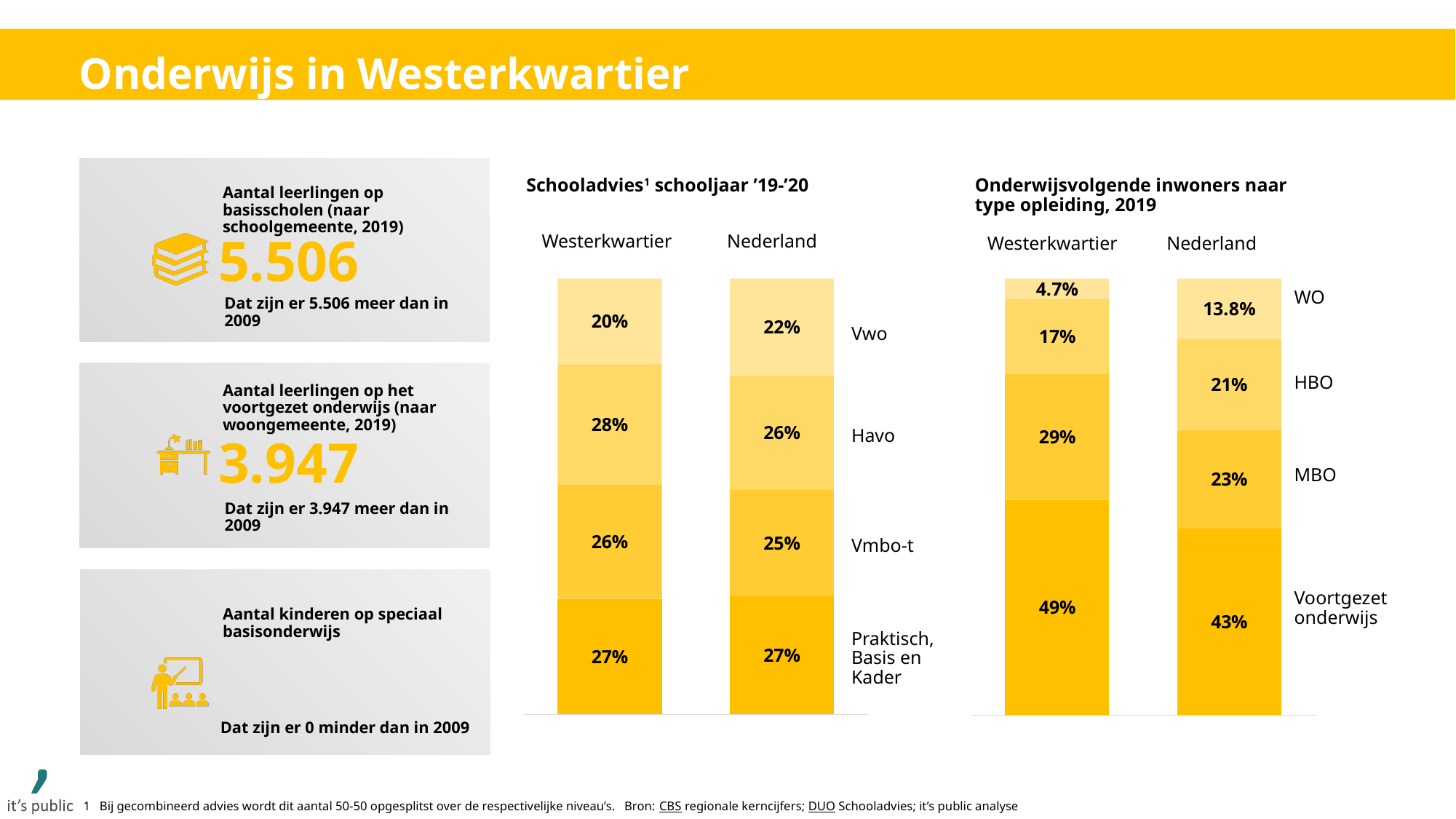
In the chart 'Onderwijsvolgende inwoners naar type opleiding, 2019', what is the difference between the Voortgezet onderwijs shares of Westerkwartier and Nederland? 6% In the chart 'Schooladvies schooljaar '19-'20', which segment is the largest in the Westerkwartier bar? Havo In the chart 'Onderwijsvolgende inwoners naar type opleiding, 2019', which segment is the smallest in the Nederland bar? WO How many bars does the chart 'Onderwijsvolgende inwoners naar type opleiding, 2019' show? 2 In the chart 'Onderwijsvolgende inwoners naar type opleiding, 2019', what is the WO share for Westerkwartier? 4.7% What kind of chart is 'Schooladvies schooljaar '19-'20'? Stacked bar chart In the chart 'Onderwijsvolgende inwoners naar type opleiding, 2019', what is the MBO share for Nederland? 23% In the chart 'Schooladvies schooljaar '19-'20', which is larger: the Vmbo-t share for Westerkwartier or for Nederland? Westerkwartier In the chart 'Schooladvies schooljaar '19-'20', what is the difference between the Vwo shares of Nederland and Westerkwartier? 2% In the chart 'Schooladvies schooljaar '19-'20', what is the Havo share for Westerkwartier? 28% In the chart 'Onderwijsvolgende inwoners naar type opleiding, 2019', which is larger: the HBO share for Westerkwartier or for Nederland? Nederland In the chart 'Schooladvies schooljaar '19-'20', what is the Vwo share for Nederland? 22%